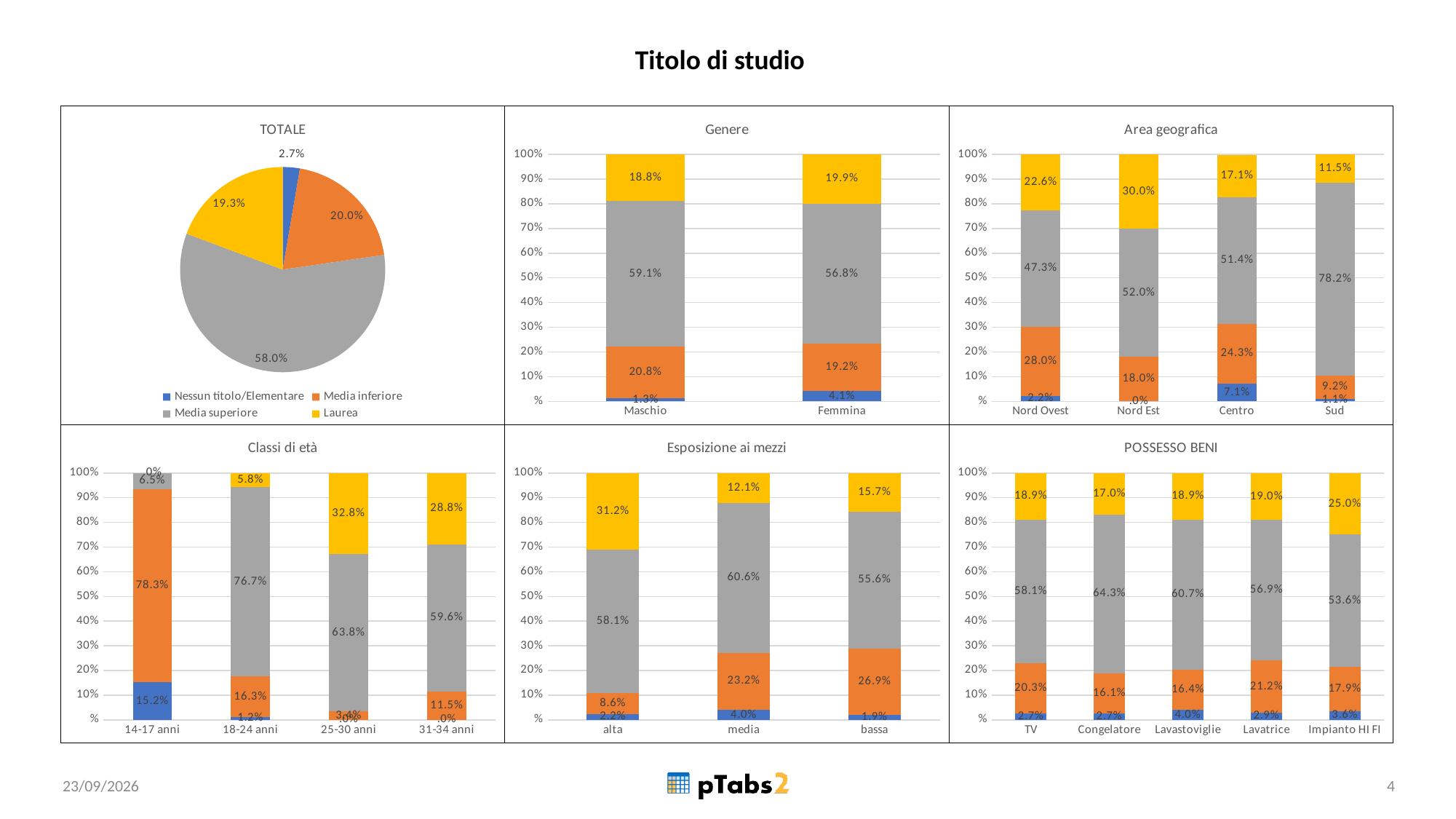
How many series does the legend on the TOTALE chart list? 4 In the TOTALE pie chart, what share does Media superiore have? 58.0% In the Esposizione ai mezzi chart, which category has the highest Laurea value? alta In the Classi di età chart, how many age classes are shown on the x axis? 4 In the POSSESSO BENI chart, what is the Laurea value for Impianto HI FI? 25.0% In the Classi di età chart, what is the Media inferiore value for 14-17 anni? 78.3% In the Esposizione ai mezzi chart, is the Media inferiore value for media larger or smaller than for bassa? smaller In the Genere chart, what is the difference between the Media superiore values for Maschio and Femmina? 2.3% In the Genere chart, what is the Laurea value for Femmina? 19.9% In the Area geografica chart, which area has the highest Media superiore value? Sud In the TOTALE pie chart, which category has the smallest slice? Nessun titolo/Elementare In the Area geografica chart, what is the Laurea value for Nord Est? 30.0%